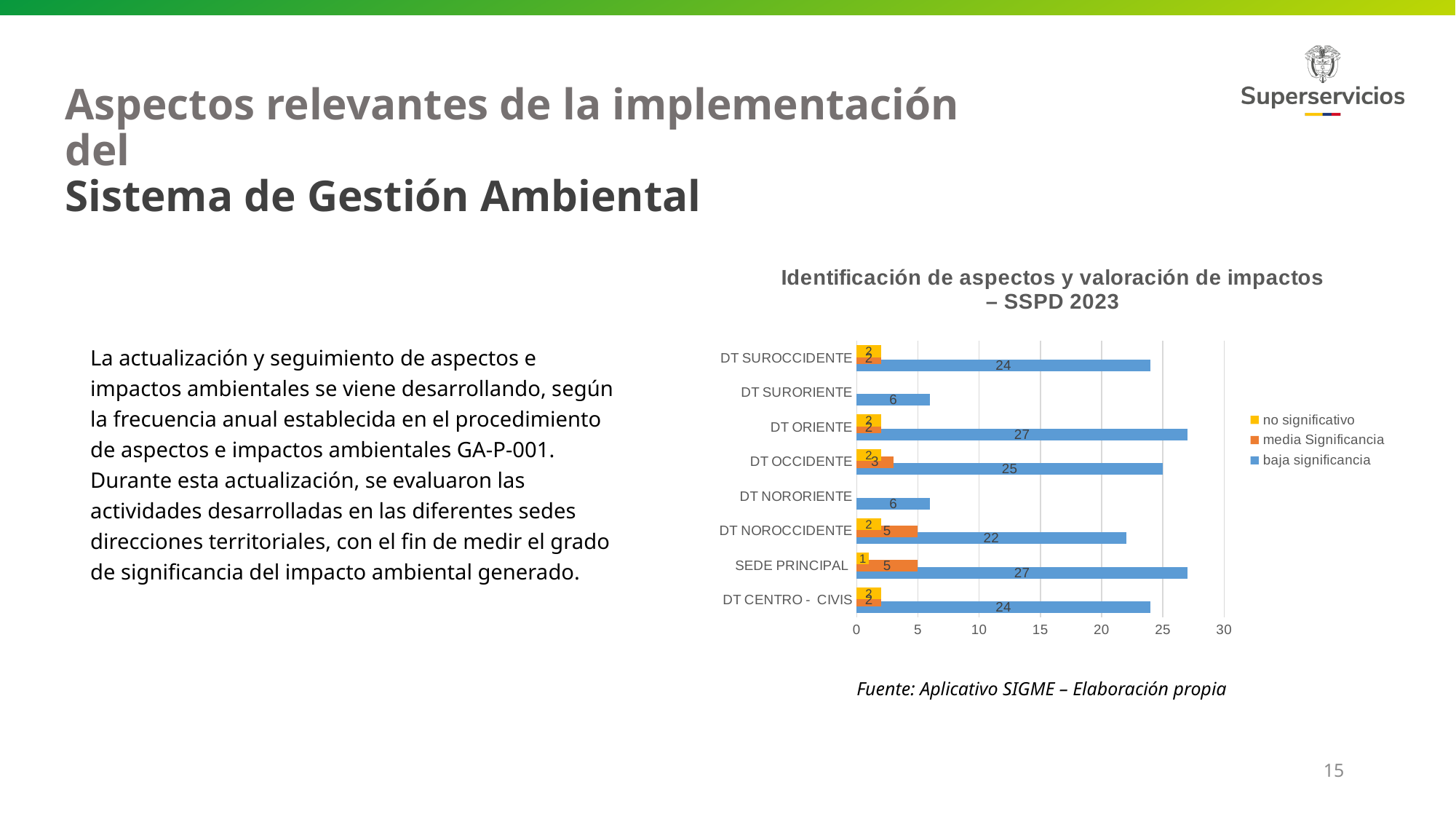
What is the difference between the media Significancia values for SEDE PRINCIPAL and DT CENTRO - CIVIS? 3 How many series does the legend list? 3 What is the title of the chart? Identificación de aspectos y valoración de impactos – SSPD 2023 What is the value of baja significancia for DT NOROCCIDENTE? 22 What is the value of no significativo for SEDE PRINCIPAL? 1 What is the value of baja significancia for DT SURORIENTE? 6 What is the value of media Significancia for DT OCCIDENTE? 3 What is the difference between the baja significancia values for DT ORIENTE and DT NOROCCIDENTE? 5 Which has a larger baja significancia value, DT OCCIDENTE or DT SUROCCIDENTE? DT OCCIDENTE Which category has the lowest value for no significativo? SEDE PRINCIPAL How many categories are shown on the chart? 8 What kind of chart is shown on the slide? Bar chart